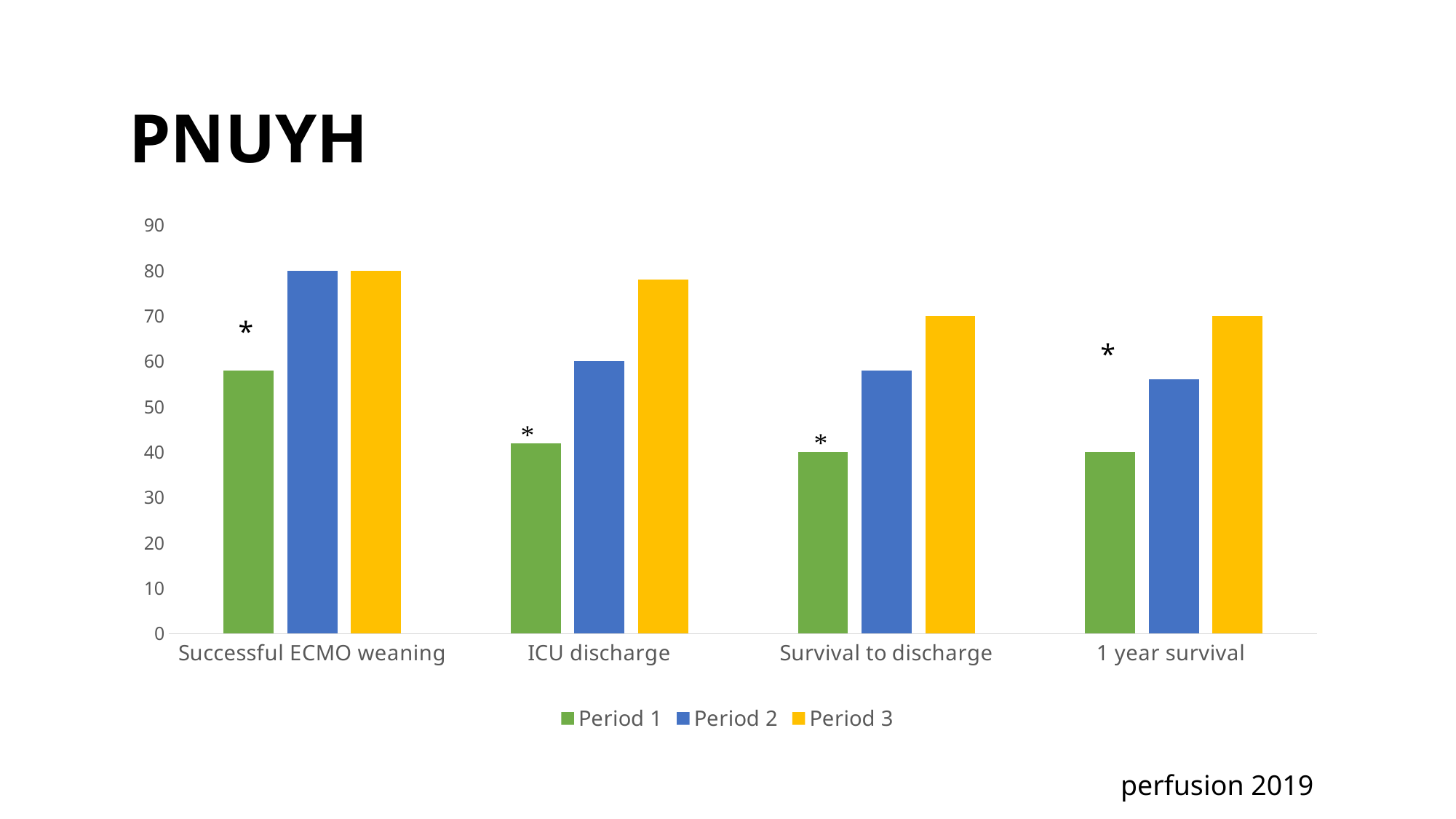
What is the value for Period 2 in the Successful ECMO weaning category? 80 How many categories are shown on the x axis? 4 What is the difference between the Period 3 value for Successful ECMO weaning and the Period 3 value for Survival to discharge? 10 What kind of chart is shown on the slide? bar chart Which period has the highest value in the Survival to discharge category? Period 3 Is the value for Period 2 in the 1 year survival category greater or less than 60? less What is the value for Period 2 in the ICU discharge category? 60 How many series does the legend list? 3 Is the value for Period 3 in the ICU discharge category greater or less than 80? less Which period has the lowest value in the ICU discharge category? Period 1 Is the value for Period 1 in the Successful ECMO weaning category greater or less than 60? less What is the value for Period 3 in the 1 year survival category? 70